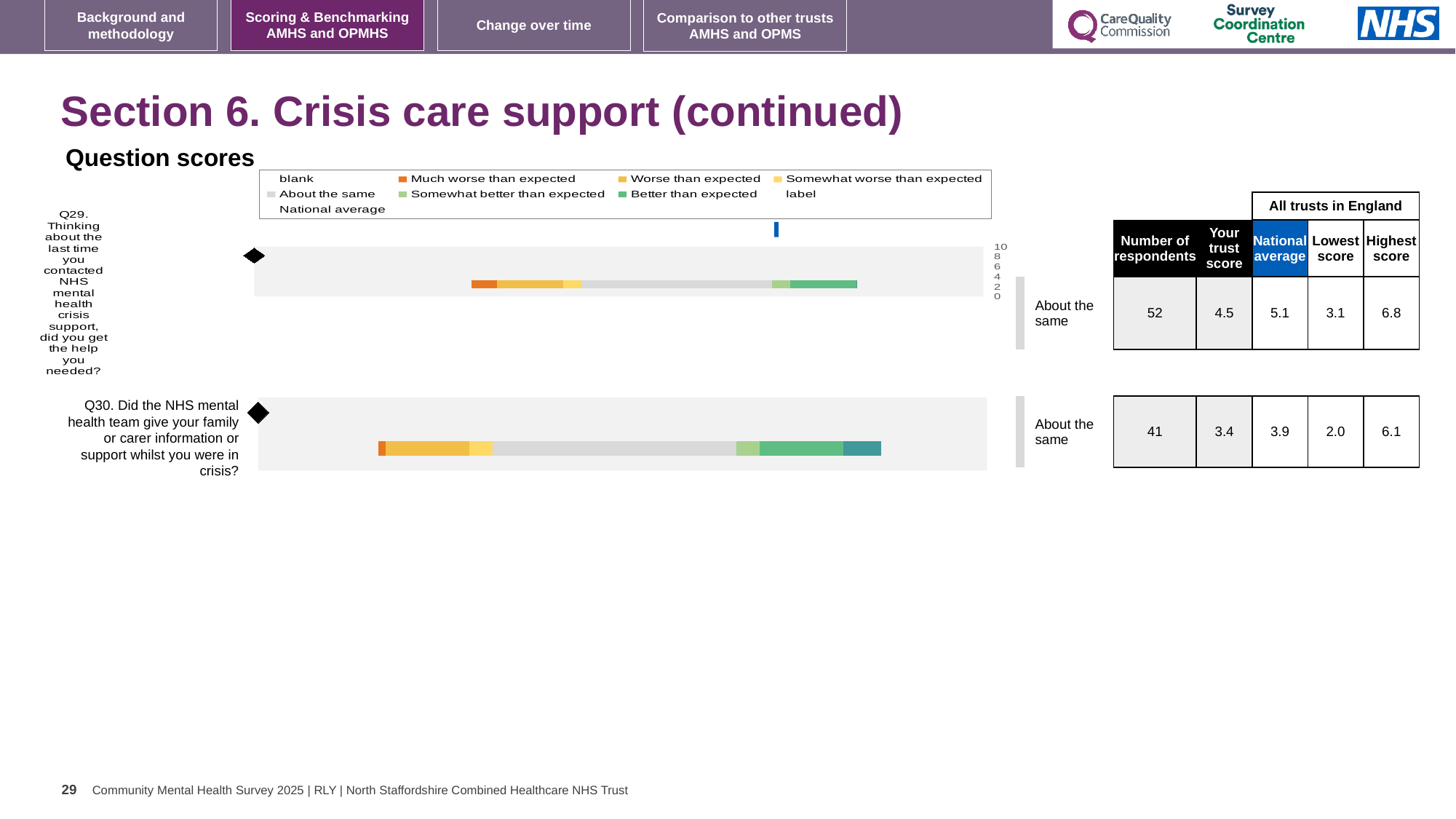
What is the national average shown for Q30? 3.9 What is the 'Your trust score' value shown for Q30? 3.4 What benchmark category is shown for both Q29 and Q30? About the same What kind of chart is used to show the question scores for Q29 and Q30? Bar chart What is the difference between the national average and the trust score for Q29? 0.6 How many respondents are shown for Q29? 52 How many entries does the legend of the question scores chart list? 9 What is the 'Your trust score' value shown for Q29? 4.5 How many questions (bars) are plotted in the question scores chart? 2 In the question scores chart legend, which colour represents 'About the same'? Grey Which question has the higher trust score, Q29 or Q30? Q29 In the question scores chart legend, which colour represents 'Much worse than expected'? Orange